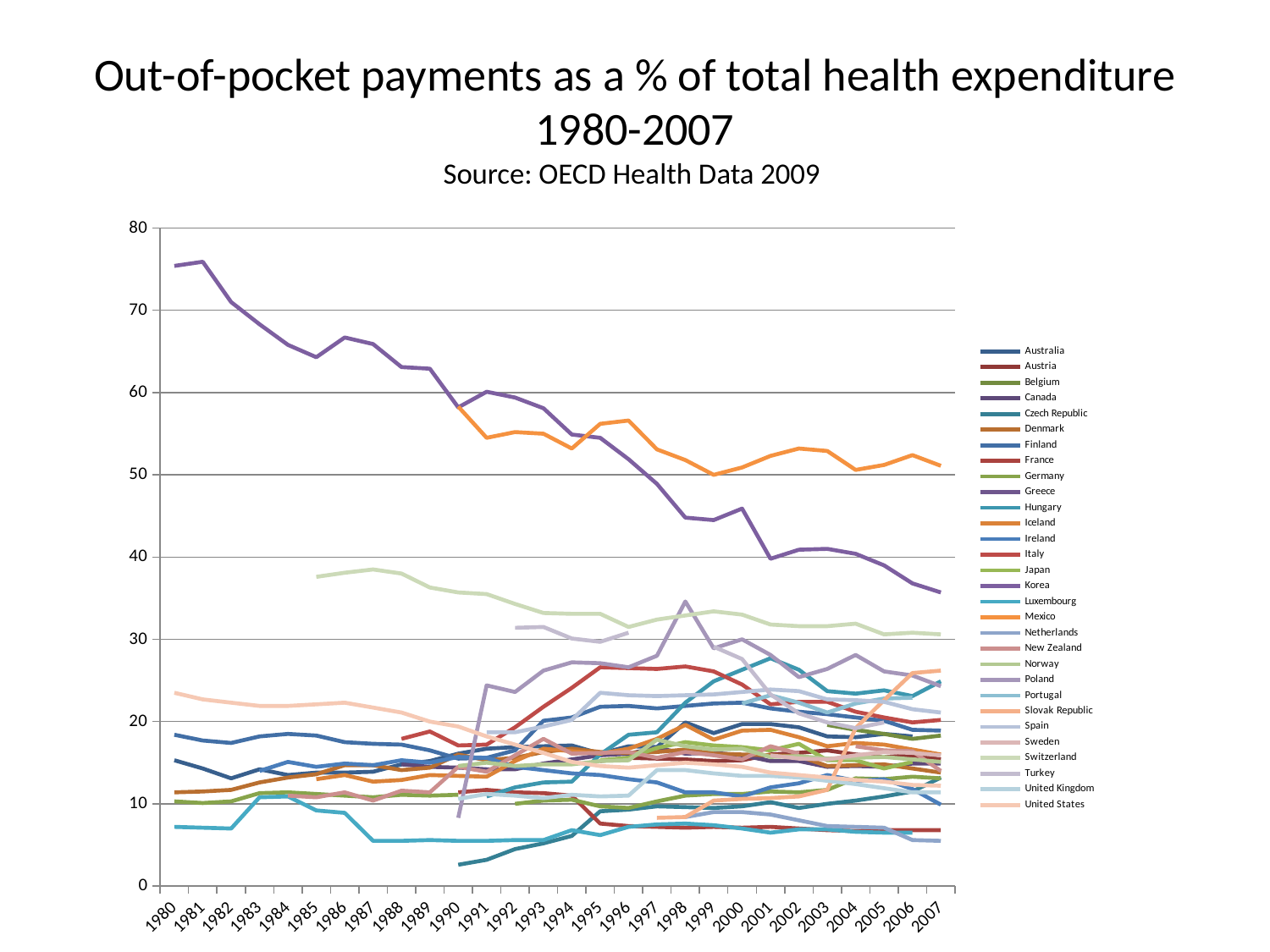
What is the first year shown on the x axis? 1980 How many series does the legend list? 30 What is the title of the chart? Out-of-pocket payments as a % of total health expenditure 1980-2007 How many years are shown along the x axis? 28 What source is cited for the chart data? OECD Health Data 2009 What kind of chart is shown on the slide? line chart Is the highest value plotted in 2007 greater or less than 60? less What is the last year shown on the x axis? 2007 Does the line that is highest in 1980 rise or fall between 1980 and 2007? fall Is the lowest value plotted in 2007 greater or less than 10? less Is the highest value plotted in 1980 greater or less than 70? greater What is the highest value shown on the y axis? 80